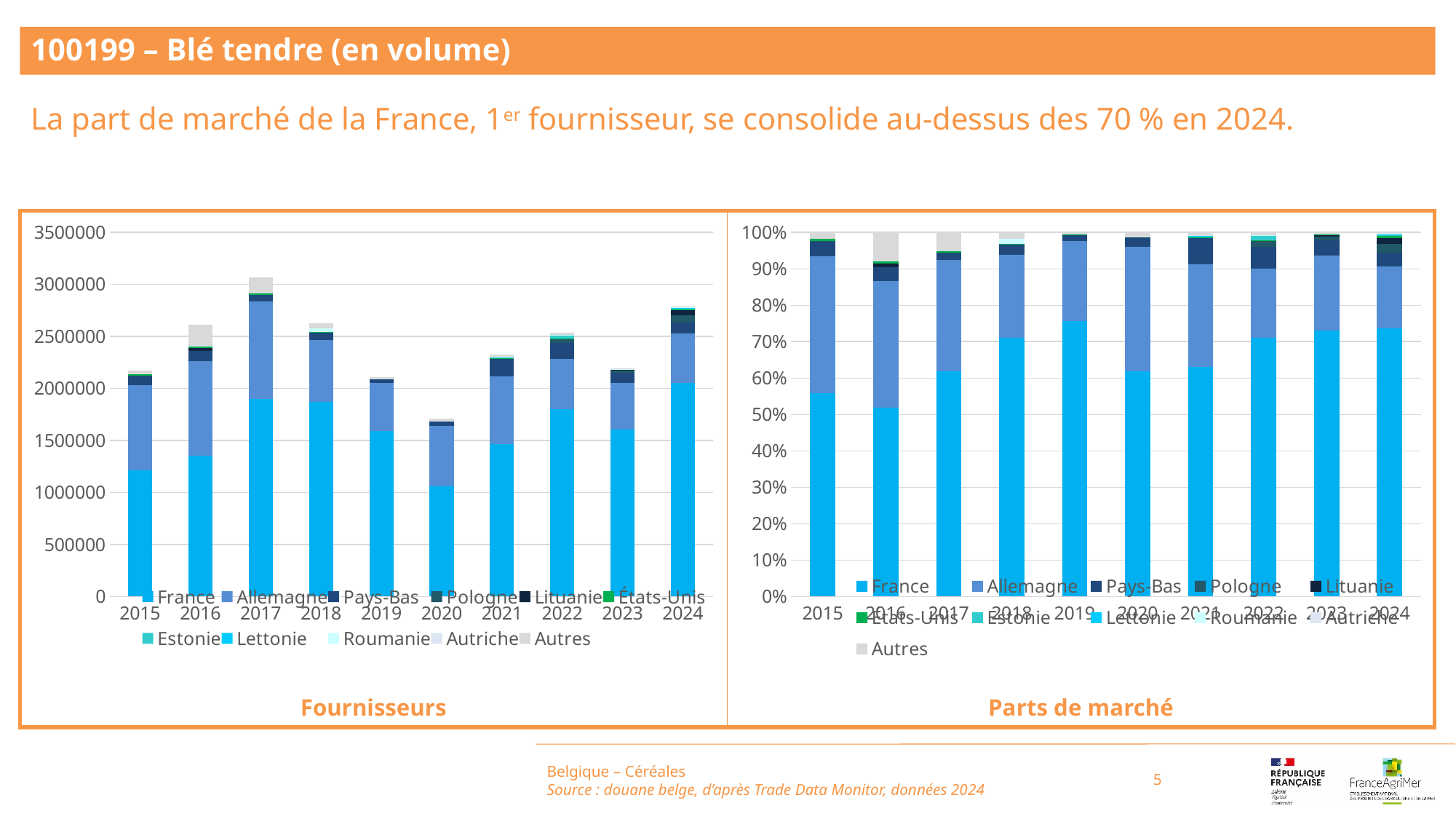
What kind of chart is the 'Fournisseurs' chart? bar chart In the 'Fournisseurs' chart, which year has the highest total bar? 2017 In the 'Fournisseurs' chart, is the total bar for 2020 greater or less than 2000000? less In the 'Fournisseurs' chart, is the value for France in 2015 greater or less than 1000000? greater In the 'Parts de marché' chart, is the share of France in 2019 greater or less than 70%? greater In the 'Parts de marché' chart, which year has the lowest share for France? 2016 In the 'Fournisseurs' chart, which year has the lowest total bar? 2020 How many years are shown on the x axis of the 'Parts de marché' chart? 10 How many series does the legend of the 'Fournisseurs' chart list? 11 In the 'Fournisseurs' chart, which is larger: the France value in 2017 or in 2020? 2017